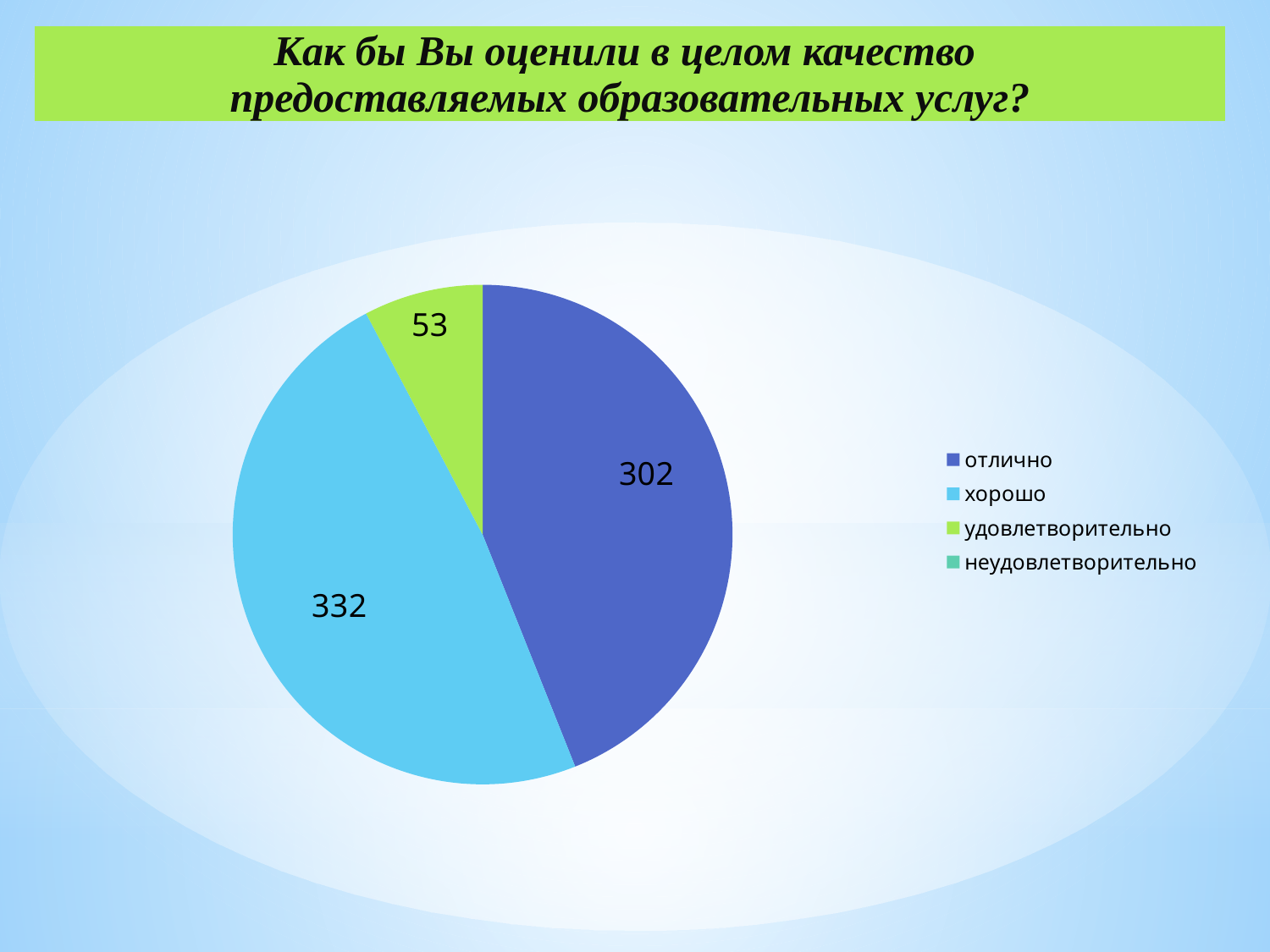
What colour is the "хорошо" slice? light blue What is the difference between the "хорошо" and "отлично" values? 30 Which labelled slice has the smallest value? удовлетворительно What type of chart is shown on the slide? pie chart What is the value for the "удовлетворительно" slice? 53 What is the value for the "отлично" slice? 302 How many slices have a data label printed on the pie? 3 Which is larger, the value for "отлично" or for "удовлетворительно"? отлично How many entries does the legend list? 4 What is the value for the "хорошо" slice? 332 Which category has the largest slice? хорошо What is the difference between the "отлично" and "удовлетворительно" values? 249